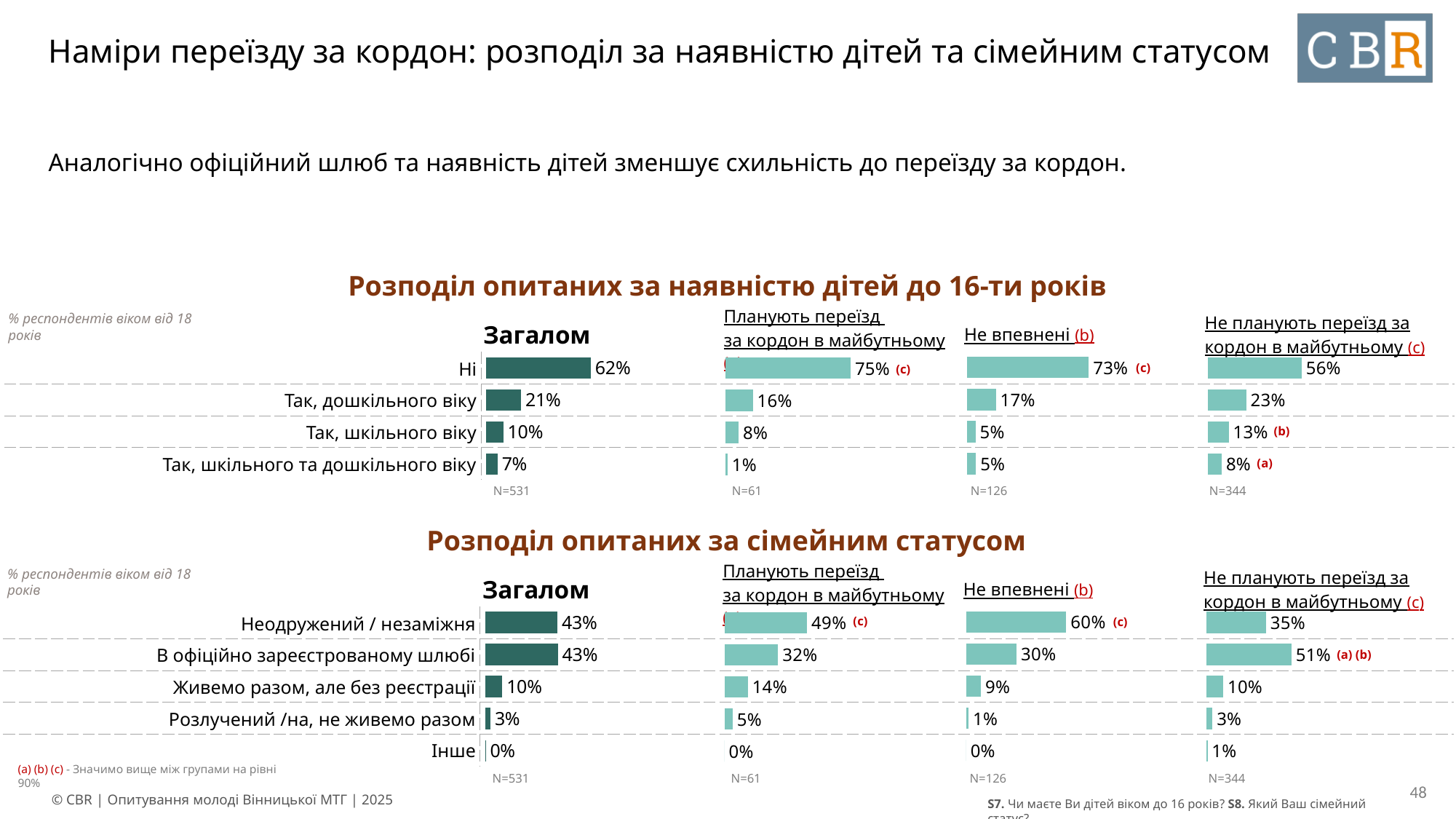
In the chart 'Розподіл опитаних за наявністю дітей до 16-ти років', how many categories are listed? 4 In the chart 'Розподіл опитаних за сімейним статусом', how many categories are listed? 5 In the chart 'Розподіл опитаних за сімейним статусом', what is the value for 'Неодружений / незаміжня' in the 'Не впевнені' column? 60% In the chart 'Розподіл опитаних за сімейним статусом', which is larger in the 'Планують переїзд за кордон в майбутньому' column: 'Неодружений / незаміжня' or 'В офіційно зареєстрованому шлюбі'? Неодружений / незаміжня In the chart 'Розподіл опитаних за наявністю дітей до 16-ти років', what is the difference between the 'Ні' values in the 'Планують переїзд за кордон в майбутньому' column and the 'Не планують переїзд за кордон в майбутньому' column? 19 percentage points In the chart 'Розподіл опитаних за наявністю дітей до 16-ти років', which category has the lowest value in the 'Планують переїзд за кордон в майбутньому' column? Так, шкільного та дошкільного віку In the chart 'Розподіл опитаних за сімейним статусом', what is the value for 'В офіційно зареєстрованому шлюбі' in the 'Не планують переїзд за кордон в майбутньому' column? 51% In the chart 'Розподіл опитаних за наявністю дітей до 16-ти років', which category has the highest value in the 'Планують переїзд за кордон в майбутньому' column? Ні In the chart 'Розподіл опитаних за наявністю дітей до 16-ти років', what is the value for 'Так, дошкільного віку' in the 'Не планують переїзд за кордон в майбутньому' column? 23% In the chart 'Розподіл опитаних за наявністю дітей до 16-ти років', what is the value for 'Ні' in the 'Загалом' column? 62% What type of chart is used on this slide? Bar chart In the chart 'Розподіл опитаних за сімейним статусом', what is the difference between 'Неодружений / незаміжня' and 'Живемо разом, але без реєстрації' in the 'Загалом' column? 33 percentage points